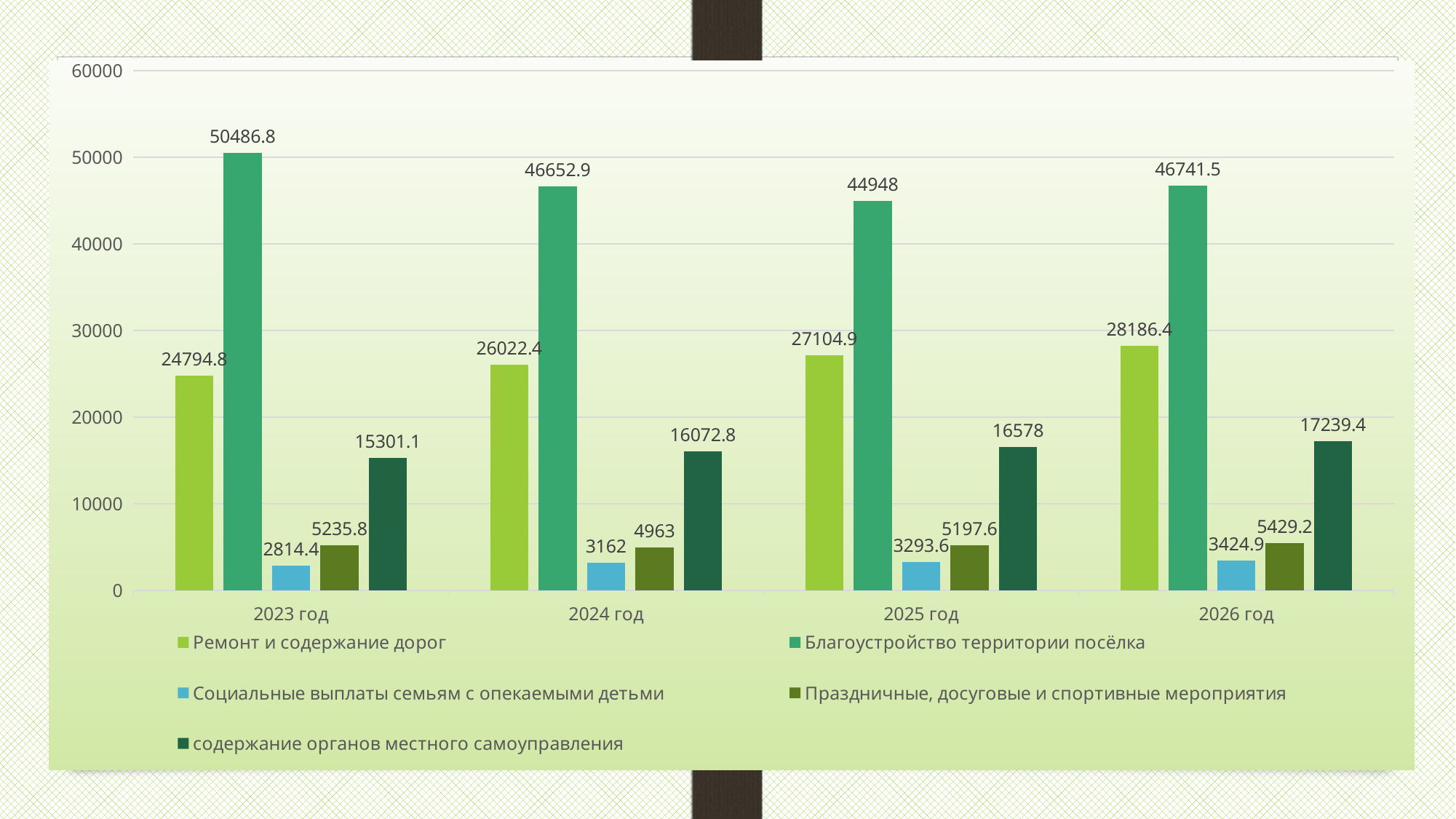
How many series does the legend list? 5 What kind of chart is shown on the slide? Bar chart In which year is the value for Благоустройство территории посёлка the highest? 2023 год In which year is the value for Социальные выплаты семьям с опекаемыми детьми the lowest? 2023 год Do the values for Ремонт и содержание дорог rise or fall from 2023 год to 2026 год? Rise How many years are shown on the x axis? 4 What is the value for Ремонт и содержание дорог in 2026 год? 28186.4 What is the value for Благоустройство территории посёлка in 2023 год? 50486.8 What is the value for Социальные выплаты семьям с опекаемыми детьми in 2024 год? 3162 What is the difference between Благоустройство территории посёлка and Ремонт и содержание дорог in 2023 год? 25692 What is the value for содержание органов местного самоуправления in 2025 год? 16578 Which is larger in 2025 год: Праздничные, досуговые и спортивные мероприятия or Социальные выплаты семьям с опекаемыми детьми? Праздничные, досуговые и спортивные мероприятия